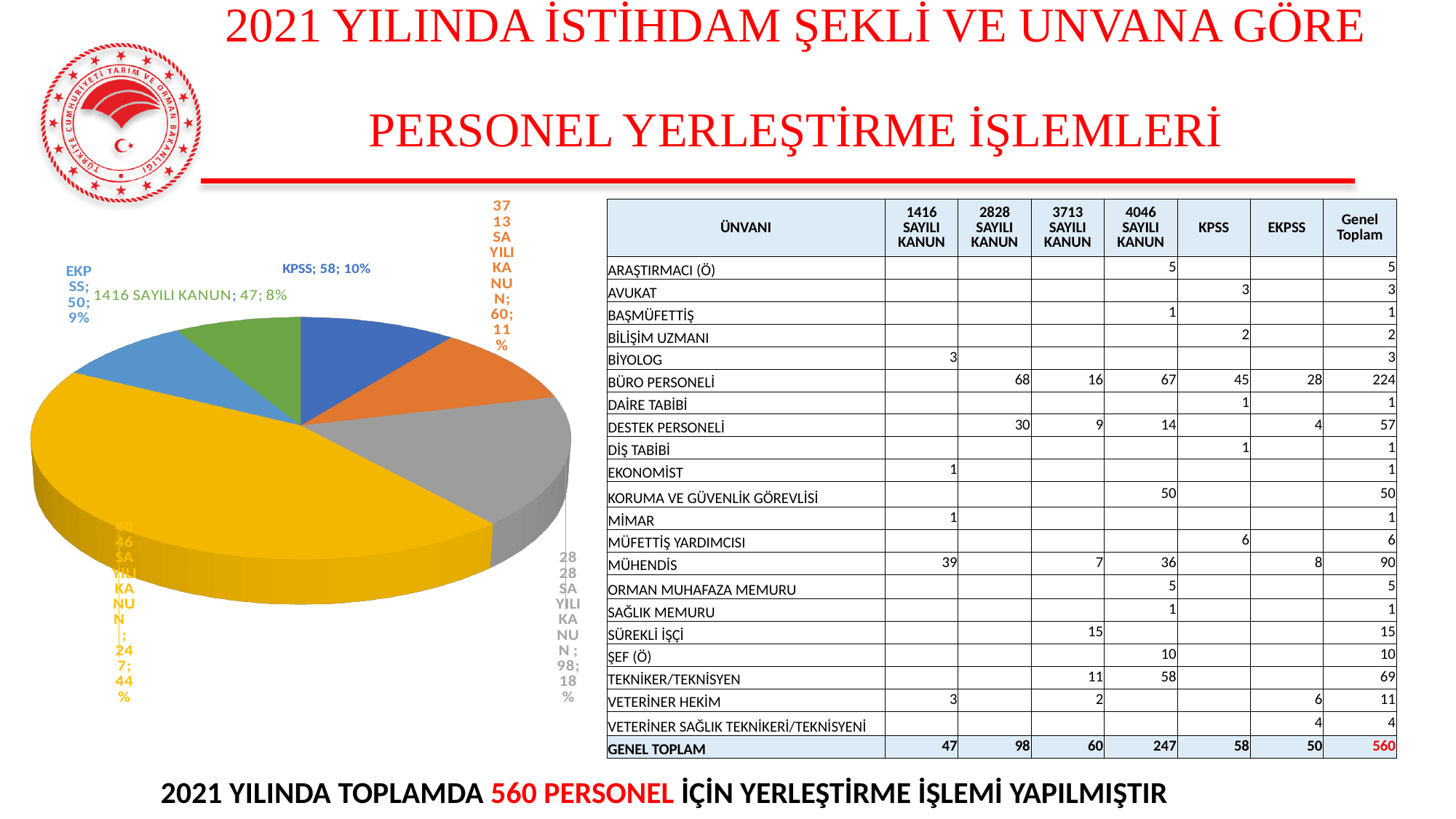
What value is shown for the 2828 SAYILI KANUN slice of the pie chart? 98 How many slices does the pie chart have? 6 Which slice of the pie chart is the largest? 4046 SAYILI KANUN What percentage share does the 3713 SAYILI KANUN slice have in the pie chart? 11% What percentage share does the 1416 SAYILI KANUN slice have in the pie chart? 8% In the pie chart, what is the difference between the 2828 SAYILI KANUN value and the 3713 SAYILI KANUN value? 38 What value is shown for the EKPSS slice of the pie chart? 50 What value is shown for the 4046 SAYILI KANUN slice of the pie chart? 247 What kind of chart is shown on the left of the slide? pie chart Which slice of the pie chart is the smallest? 1416 SAYILI KANUN What value is shown for the KPSS slice of the pie chart? 58 In the pie chart, which is larger: the KPSS slice or the EKPSS slice? KPSS